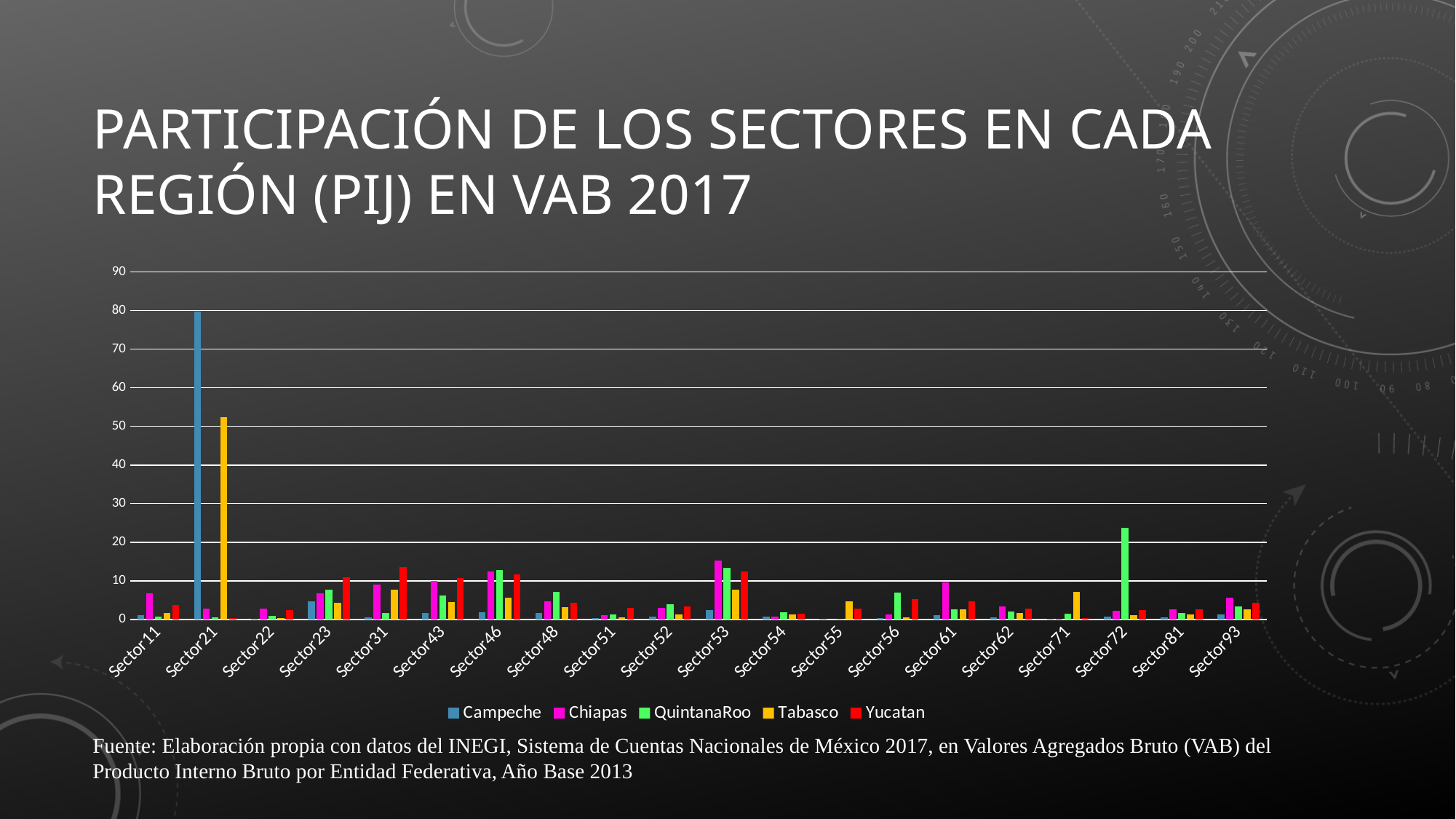
Is the value for Tabasco in Sector21 greater or less than 50? greater Which series has the highest value in Sector72? QuintanaRoo In Sector21, which is larger: the value for Campeche or the value for Tabasco? Campeche What kind of chart is shown on the slide? Bar chart Is the value for Campeche in Sector21 greater or less than 70? greater Which series is shown in orange in the legend? Tabasco In which sector does Campeche have its highest value? Sector21 How many sector categories are shown on the x axis? 20 In Sector72, which is larger: the value for QuintanaRoo or the value for Chiapas? QuintanaRoo Is the value for QuintanaRoo in Sector72 greater or less than 20? greater Which series has the highest value in Sector21? Campeche How many series does the legend list? 5